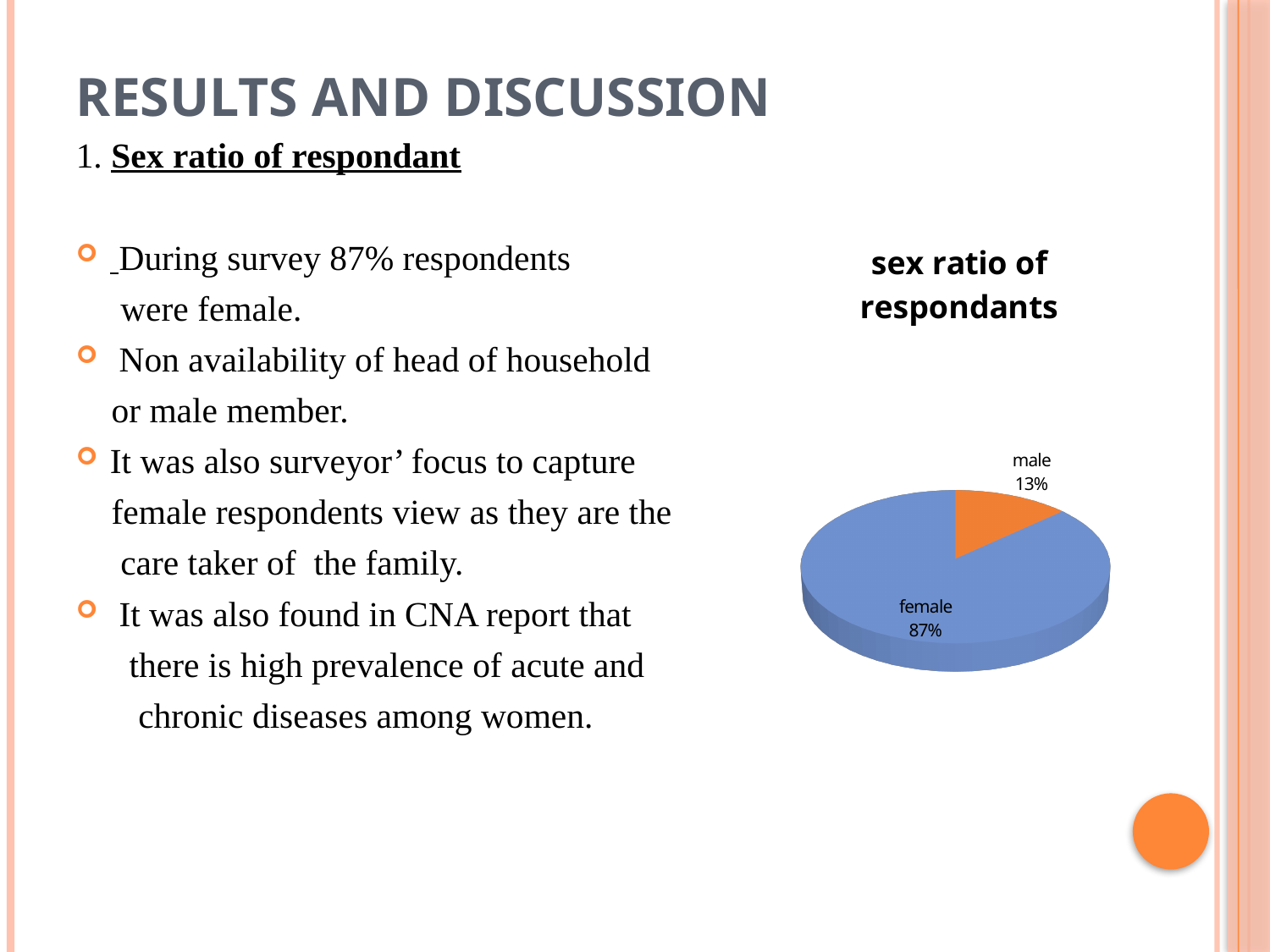
What is the difference in percentage points between the female and male shares? 74 What is the title of the chart? sex ratio of respondants Which category has the largest share in the pie chart? female How many categories are shown in the pie chart? 2 Which category has the smallest share in the pie chart? male Which share is larger, male or female? female What type of chart is shown on the slide? pie chart What percentage of respondents were female according to the pie chart? 87% What colour is the female slice of the pie chart? blue What percentage of respondents were male according to the pie chart? 13%